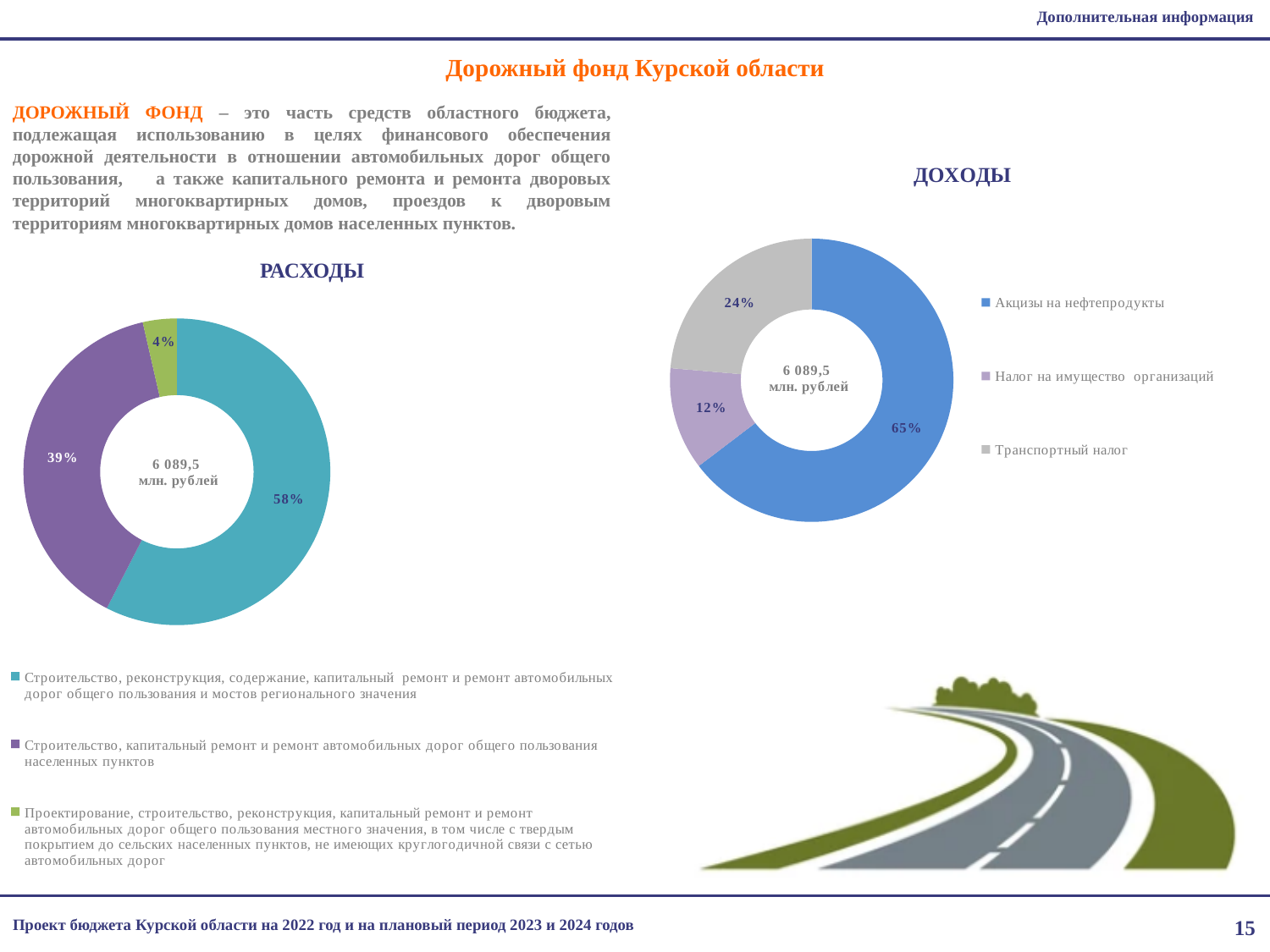
On the ДОХОДЫ chart, which category has the smallest share? Налог на имущество организаций On the РАСХОДЫ chart, which category has the largest share? Строительство, реконструкция, содержание, капитальный ремонт и ремонт автомобильных дорог общего пользования и мостов регионального значения On the РАСХОДЫ chart, what share is shown for the category on roads of local significance (Проектирование, строительство, реконструкция... местного значения)? 4% On the РАСХОДЫ chart, what is the difference in percentage points between the 58% slice and the 39% slice? 19 percentage points On the ДОХОДЫ chart, which is larger: Транспортный налог or Налог на имущество организаций? Транспортный налог On the ДОХОДЫ chart, what share is shown for Налог на имущество организаций? 12% How many categories does the legend of the ДОХОДЫ chart list? 3 On the РАСХОДЫ chart, what share is shown for construction, reconstruction, maintenance and repair of public roads and bridges of regional significance (Строительство, реконструкция, содержание, капитальный ремонт и ремонт автомобильных дорог общего пользования и мостов регионального значения)? 58% On the ДОХОДЫ chart, what share is shown for Транспортный налог? 24% On the ДОХОДЫ chart, what share is shown for Акцизы на нефтепродукты? 65% What type of chart is used for РАСХОДЫ? Doughnut (pie) chart On the РАСХОДЫ chart, what share is shown for construction and repair of public roads in populated areas (Строительство, капитальный ремонт и ремонт автомобильных дорог общего пользования населенных пунктов)? 39%